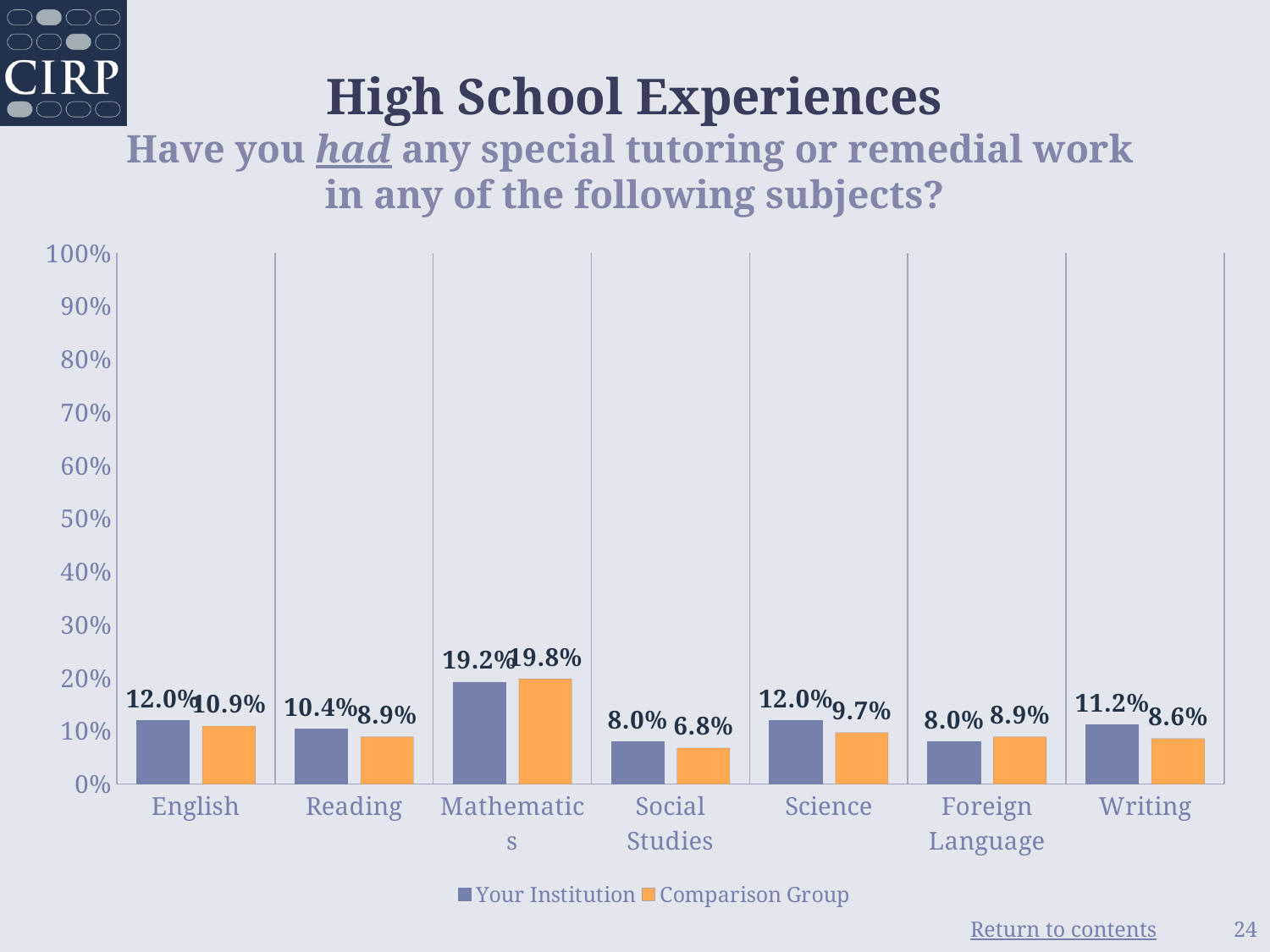
Which subject has the highest value for Your Institution? Mathematics What is the difference between Your Institution and the Comparison Group in Science? 2.3 percentage points Which subject has the lowest value for the Comparison Group? Social Studies What is the value for the Comparison Group in Social Studies? 6.8% What is the value for Your Institution in Mathematics? 19.2% What is the value for Your Institution in Writing? 11.2% Is the value for Your Institution in Mathematics greater or less than 10%? greater What is the difference between Your Institution and the Comparison Group in Writing? 2.6 percentage points How many series does the legend list? 2 How many subjects are shown on the x axis? 7 What kind of chart is shown on the slide? Bar chart In Foreign Language, which is larger: Your Institution or the Comparison Group? Comparison Group